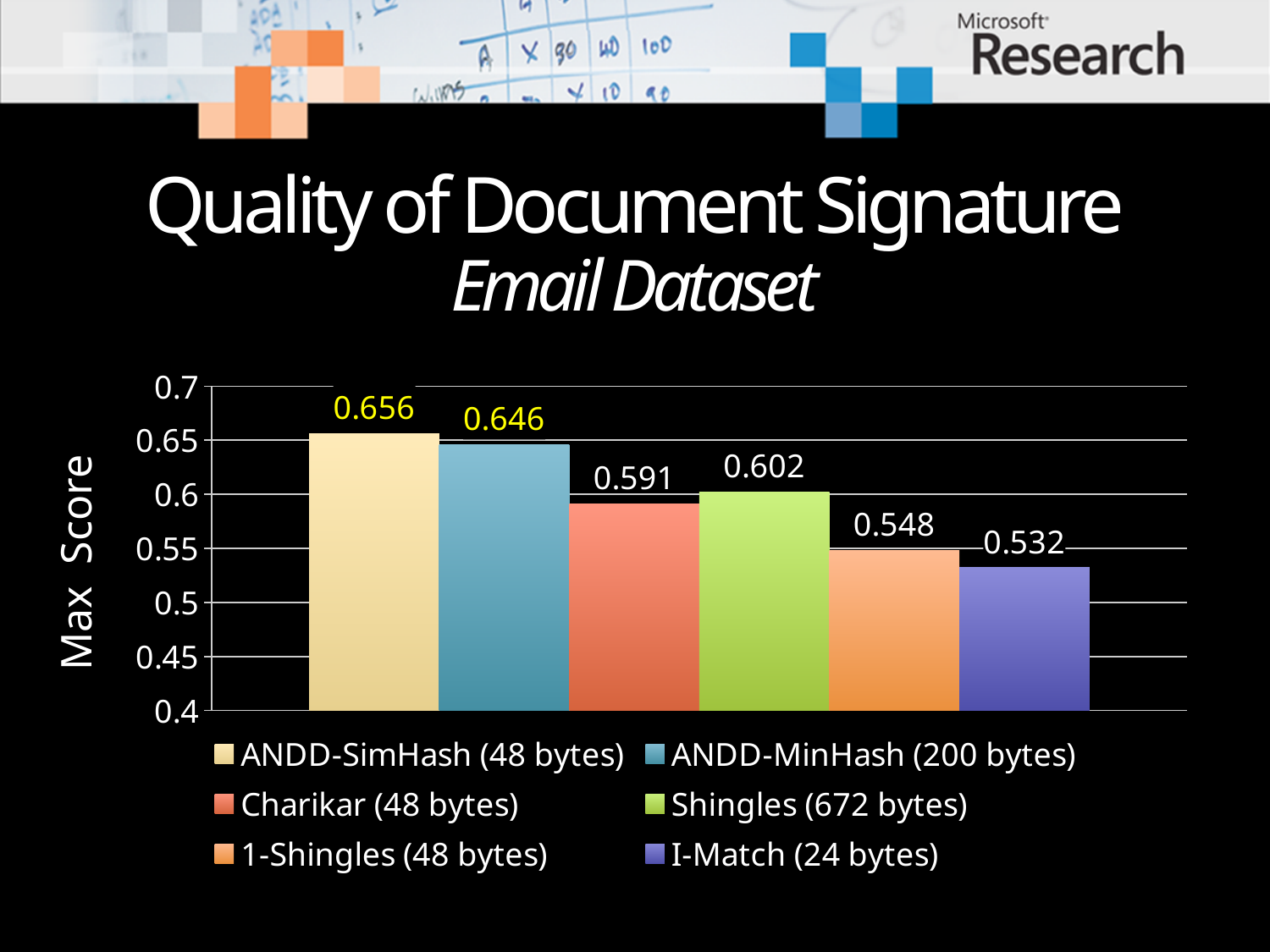
How many methods are shown in the chart? 6 Which has a higher Max Score, Charikar (48 bytes) or 1-Shingles (48 bytes)? Charikar (48 bytes) What is the difference in Max Score between ANDD-SimHash (48 bytes) and ANDD-MinHash (200 bytes)? 0.010 Is the Max Score for 1-Shingles (48 bytes) greater or less than 0.55? less Which method has the highest Max Score? ANDD-SimHash (48 bytes) What is the label of the vertical axis? Max Score What type of chart is shown on the slide? bar chart What is the Max Score for I-Match (24 bytes)? 0.532 What is the difference in Max Score between Shingles (672 bytes) and Charikar (48 bytes)? 0.011 What is the Max Score for ANDD-SimHash (48 bytes)? 0.656 What is the Max Score for Shingles (672 bytes)? 0.602 Which method has the lowest Max Score? I-Match (24 bytes)